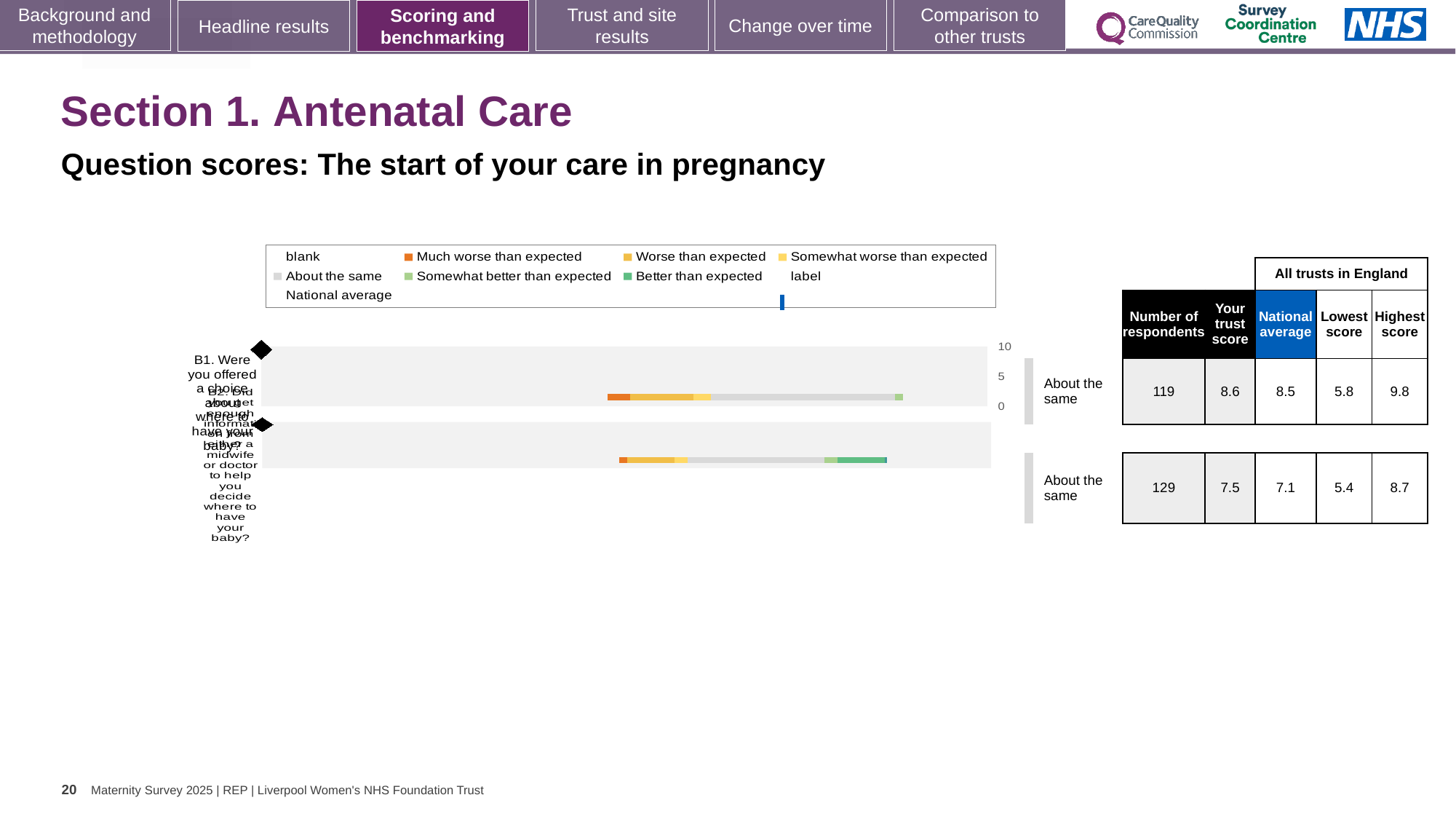
What is the 'Your trust score' for the first question, B1 (choice about where to have your baby)? 8.6 What is the highest score among all trusts in England for question B2? 8.7 By how much does the trust score for B2 exceed the national average for B2? 0.4 Which question has the higher trust score, B1 or B2? B1 How many respondents answered question B2? 129 What benchmark category is the trust placed in for both B1 and B2? About the same By how much does the trust score for B1 exceed the national average for B1? 0.1 How many questions (bars) are plotted in the chart? 2 What is the national average for the second question, B2? 7.1 What kind of chart is shown on the slide? bar chart How many respondents answered question B1? 119 What is the lowest score among all trusts in England for question B1? 5.8